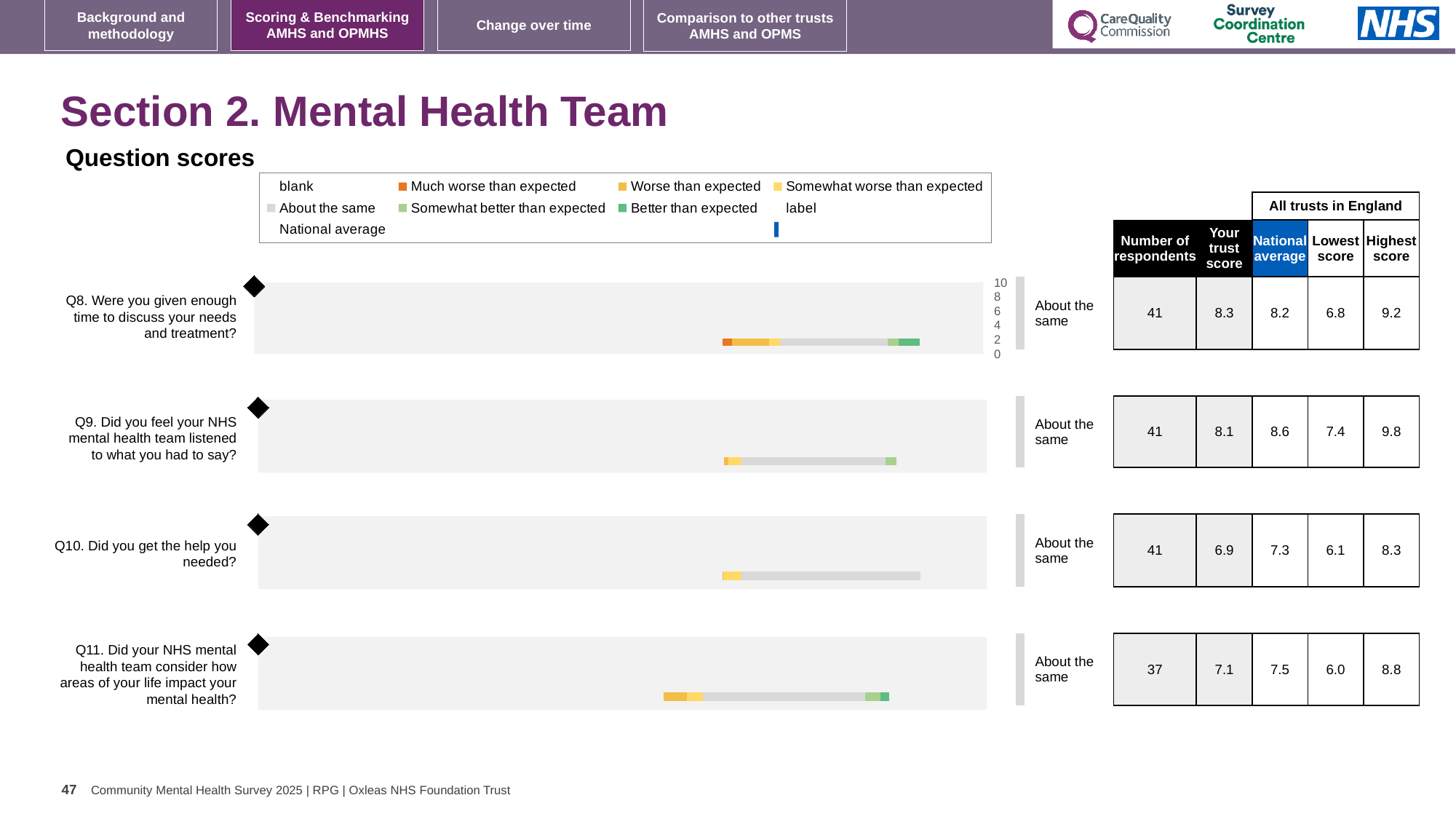
For Q8, which is larger: the trust score or the national average? Trust score Which question has the highest 'Your trust score' on this slide? Q8 What is the lowest score among all trusts in England for Q11? 6.0 How many questions are plotted on this slide? 4 Which question has the lowest 'Your trust score' on this slide? Q10 How many respondents are shown for Q11 (Did your NHS mental health team consider how areas of your life impact your mental health)? 37 What benchmark category is shown next to the chart for Q10? About the same What is the 'Your trust score' value for Q8 (Were you given enough time to discuss your needs and treatment)? 8.3 What is the difference between the national average and the trust score for Q9? 0.5 What type of chart is used to show the question scores? Bar chart What is the highest score among all trusts in England for Q9? 9.8 What is the national average score shown for Q9 (Did you feel your NHS mental health team listened to what you had to say)? 8.6